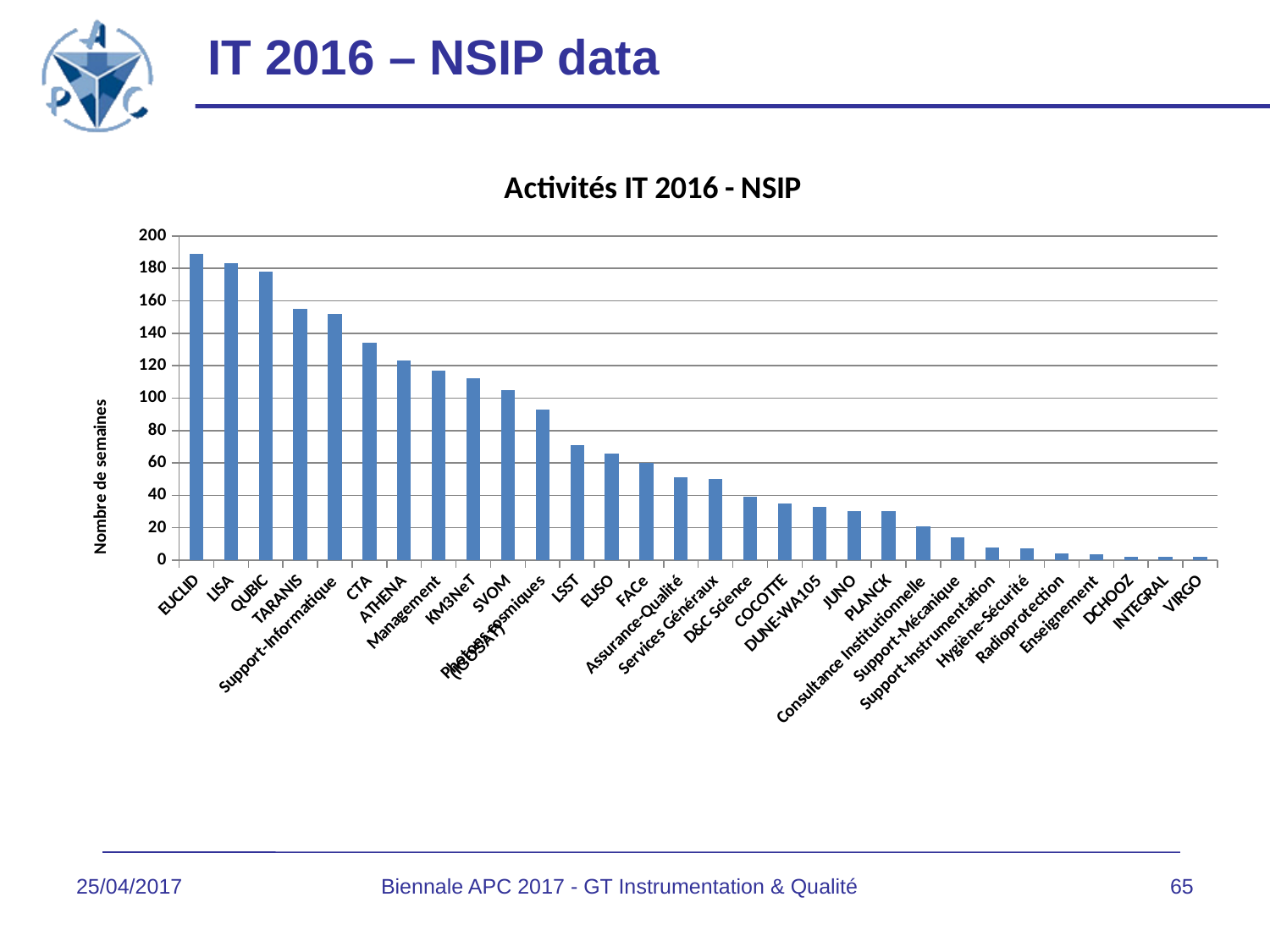
Do the values rise or fall from left to right along the x axis? fall Which category has the highest value in the chart? EUCLID Is the value for CTA greater or less than 120? greater Which has a larger value, QUBIC or TARANIS? QUBIC Is the value for TARANIS greater or less than 160? less Is the value for EUCLID greater or less than 180? greater Which has a larger value, CTA or ATHENA? CTA What kind of chart is shown on the slide? bar chart